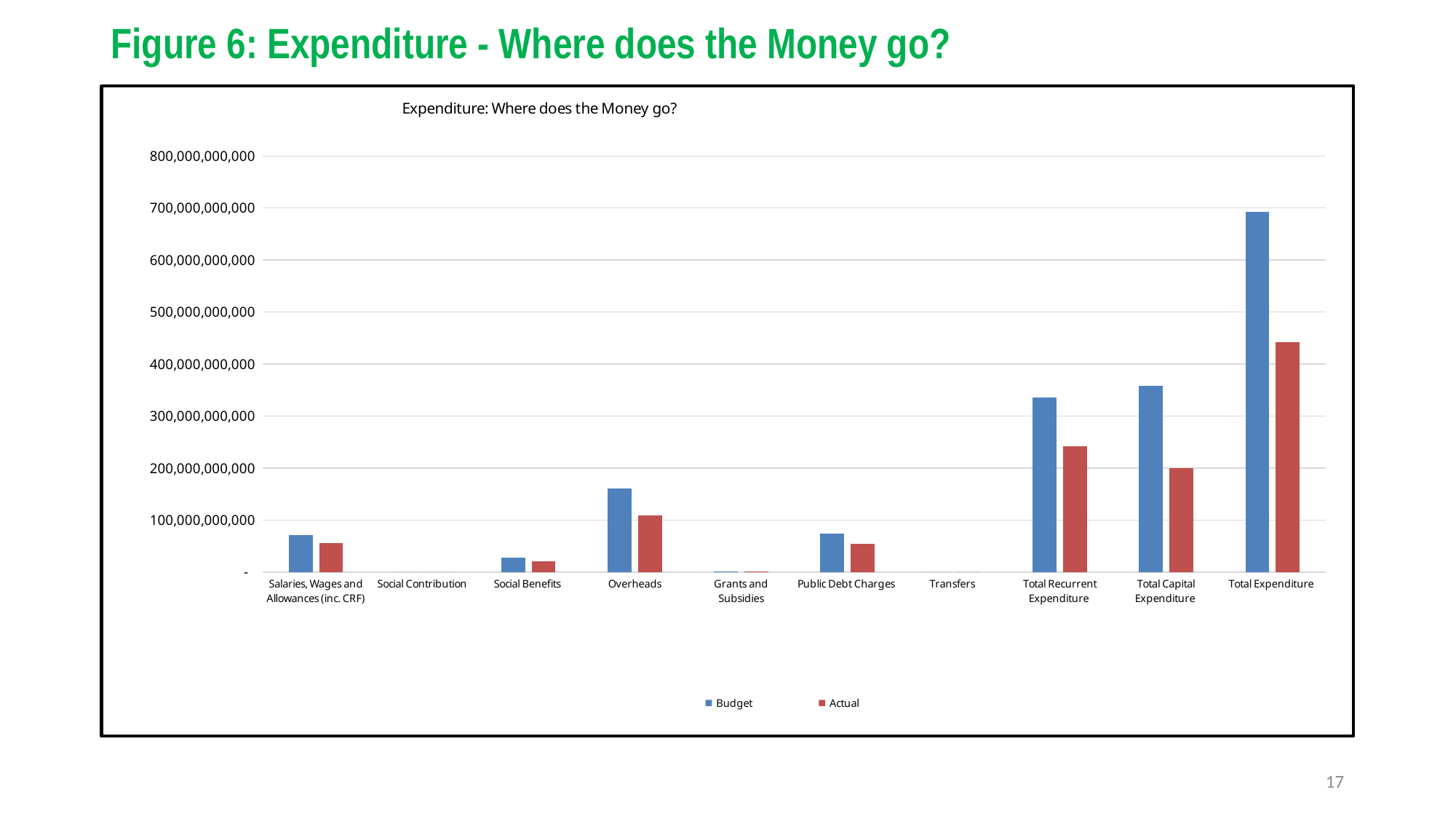
Which category has the highest Actual value? Total Expenditure Which series is shown in red in the legend? Actual How many expenditure categories are shown on the x axis? 10 Is the Budget value for Total Expenditure greater or less than 600,000,000,000? greater Is the Actual value for Total Expenditure greater or less than 400,000,000,000? greater Is the Budget value for Overheads greater or less than 100,000,000,000? greater Which category has the highest Budget value? Total Expenditure For Total Expenditure, which is larger, the Budget or the Actual value? Budget How many series does the legend list? 2 What kind of chart is shown on the slide? Bar chart